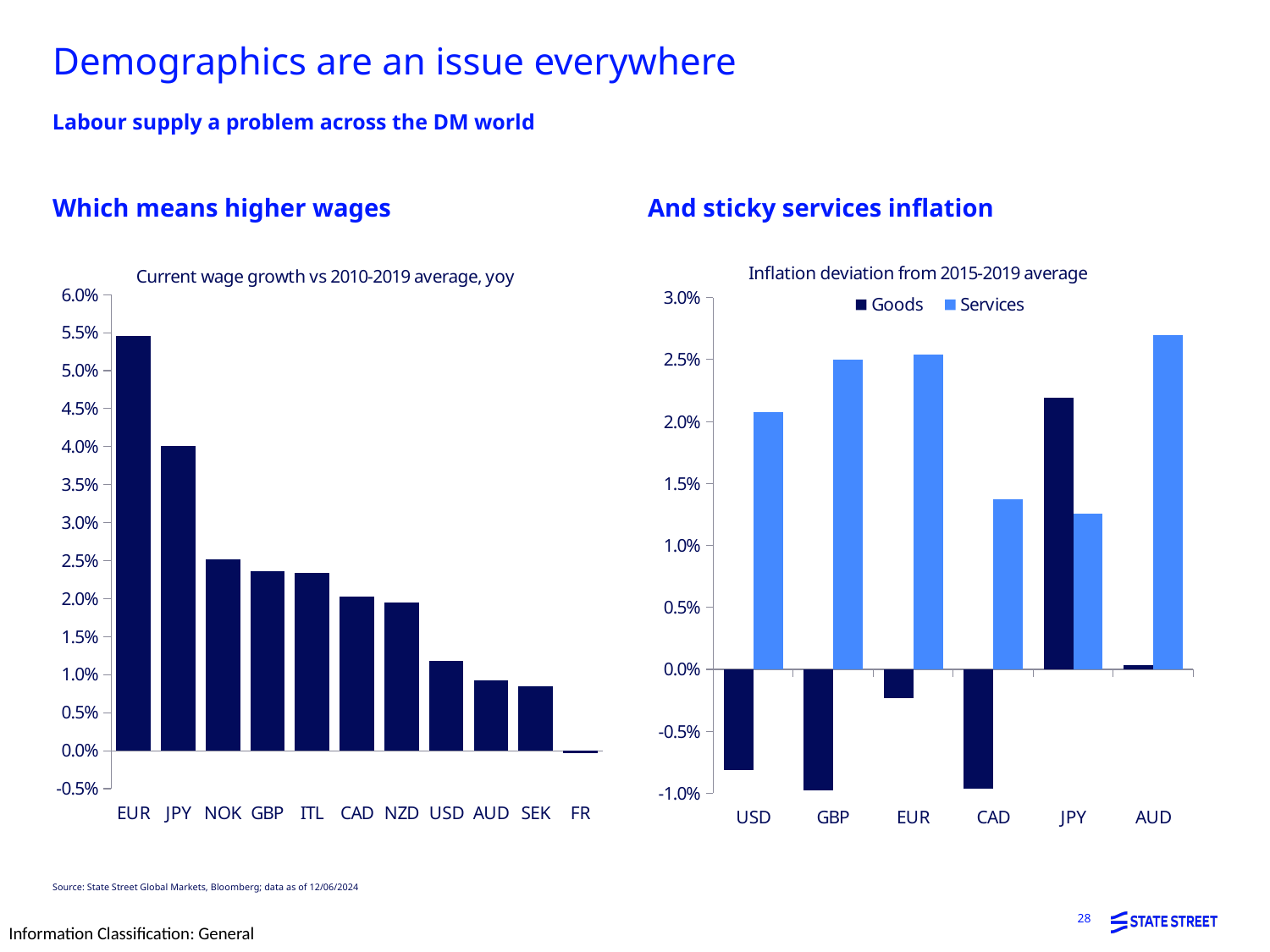
In the chart titled 'Current wage growth vs 2010-2019 average, yoy', what kind of chart is shown? bar chart In the chart titled 'Current wage growth vs 2010-2019 average, yoy', is the value for USD greater or less than 1.5%? less In the chart titled 'Current wage growth vs 2010-2019 average, yoy', do the values generally rise or fall from left to right along the x axis? fall In the chart titled 'Inflation deviation from 2015-2019 average', which currency has the highest Goods value? JPY In the chart titled 'Inflation deviation from 2015-2019 average', which currency has the highest Services value? AUD In the chart titled 'Current wage growth vs 2010-2019 average, yoy', how many currencies are plotted on the x axis? 11 In the chart titled 'Inflation deviation from 2015-2019 average', is the Goods value for JPY larger or smaller than the Services value for JPY? larger In the chart titled 'Current wage growth vs 2010-2019 average, yoy', which currency has the highest value? EUR In the chart titled 'Inflation deviation from 2015-2019 average', how many series does the legend list? 2 In the chart titled 'Current wage growth vs 2010-2019 average, yoy', which currency has the lowest value? FR In the chart titled 'Inflation deviation from 2015-2019 average', is the Goods value for CAD greater or less than -0.5%? less In the chart titled 'Current wage growth vs 2010-2019 average, yoy', is the value for JPY greater or less than 3.0%? greater